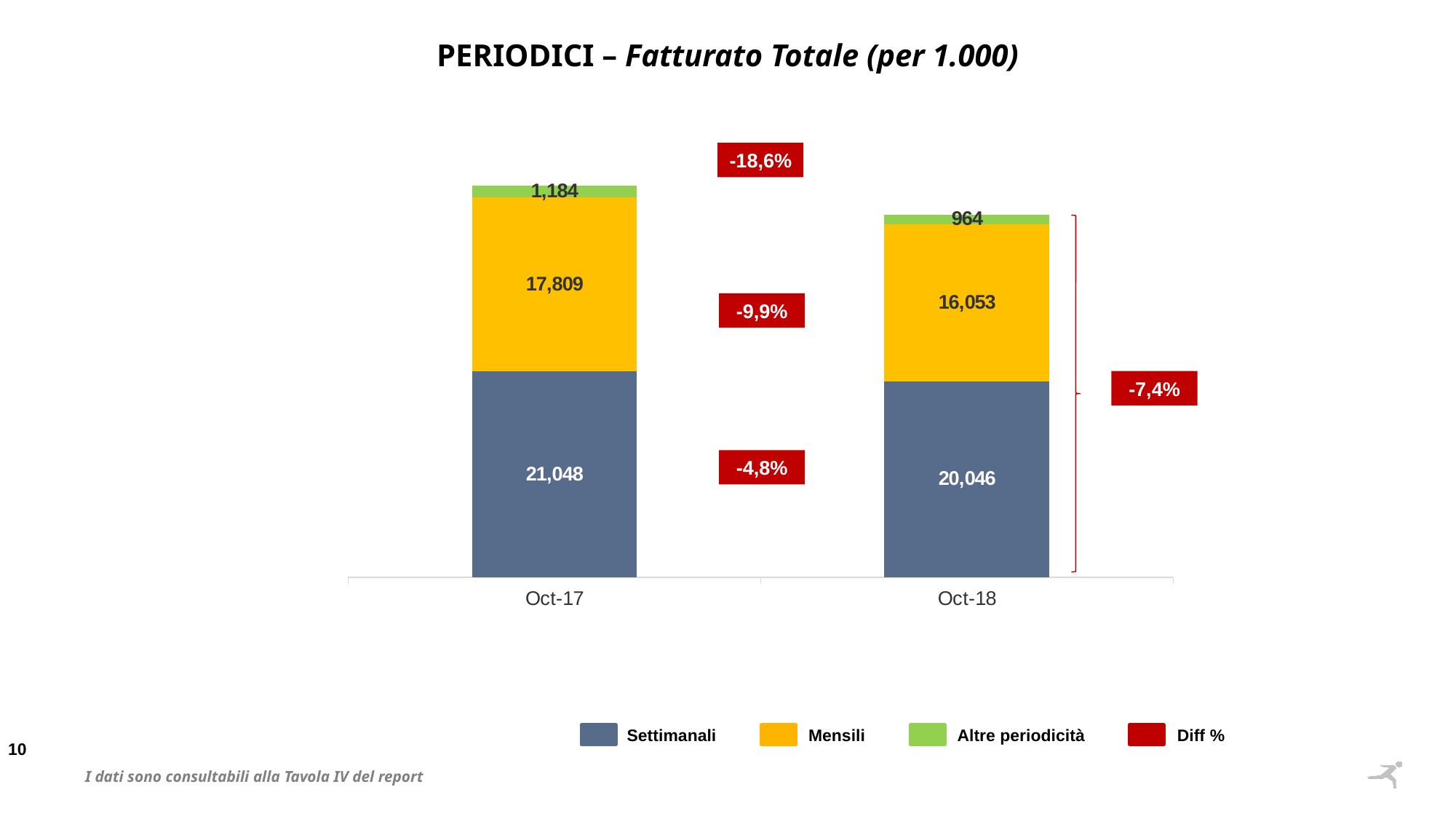
What is the value for Altre periodicità in Oct-17? 1,184 Which series has the smallest value in Oct-17? Altre periodicità What is the difference between the Mensili values for Oct-17 and Oct-18? 1,756 How many categories are shown on the x axis? 2 What is the overall percentage change shown for the total between Oct-17 and Oct-18? -7,4% What type of chart is shown on the slide? Stacked bar chart What is the total of the stacked bar for Oct-18? 37,063 What percentage change is shown for Altre periodicità between Oct-17 and Oct-18? -18,6% Is the Settimanali value larger in Oct-17 or Oct-18? Oct-17 What is the value for Mensili in Oct-18? 16,053 Which series has the largest value in Oct-18? Settimanali What is the value for Settimanali in Oct-17? 21,048